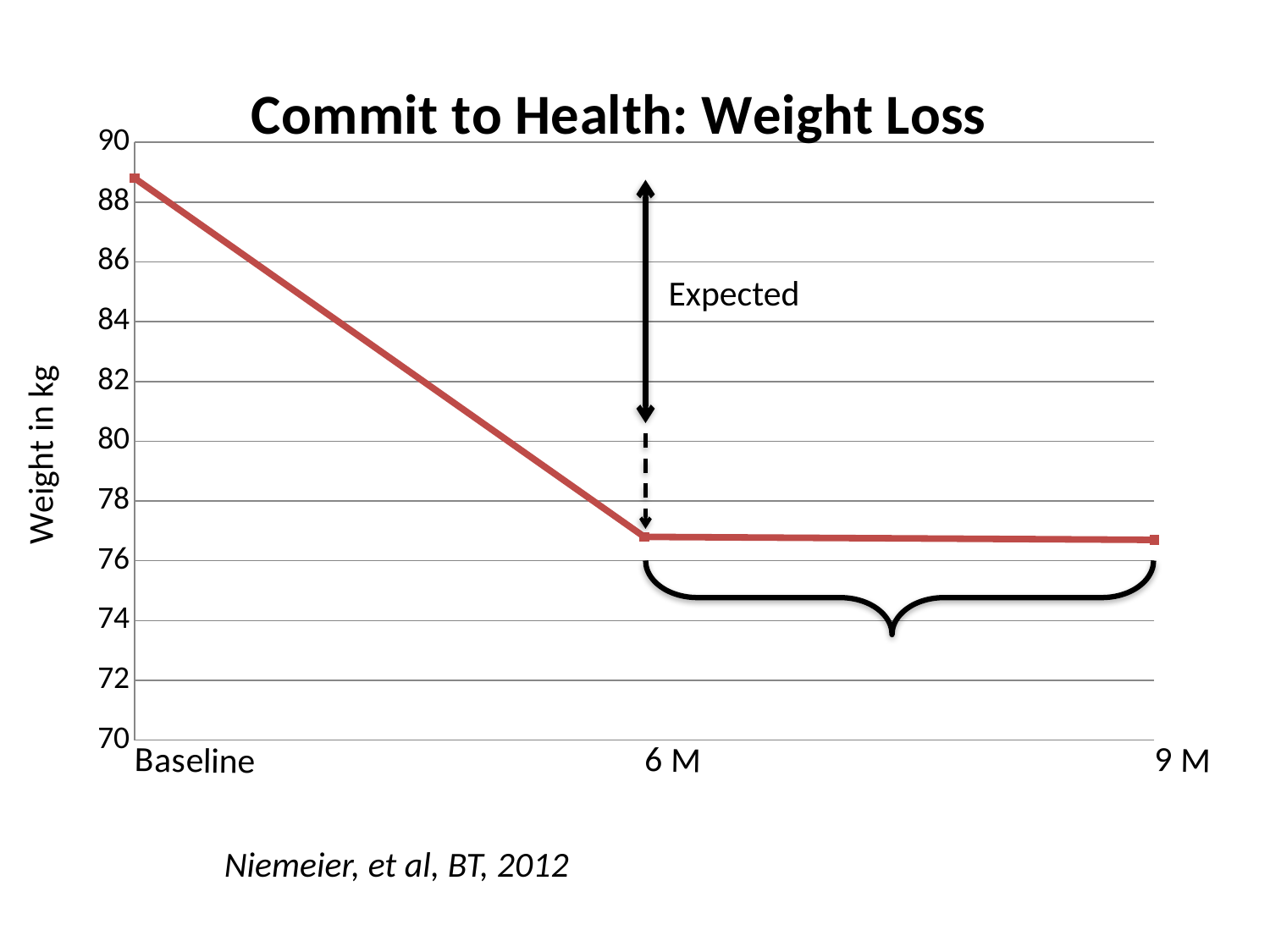
Does the weight change much between 6 M and 9 M, or stay roughly flat? stays roughly flat Is the weight at 9 M greater or less than 80 kg? less Does the weight rise or fall from Baseline to 6 M? fall Which is larger, the weight at Baseline or the weight at 6 M? Baseline At which time point is the weight highest? Baseline Is the weight at Baseline greater or less than 88 kg? greater Is the weight at 6 M greater or less than 78 kg? less What kind of chart is shown on the slide? line chart How many time points are plotted on the x axis? 3 What is the label on the vertical axis of the chart? Weight in kg What is the title of the chart? Commit to Health: Weight Loss